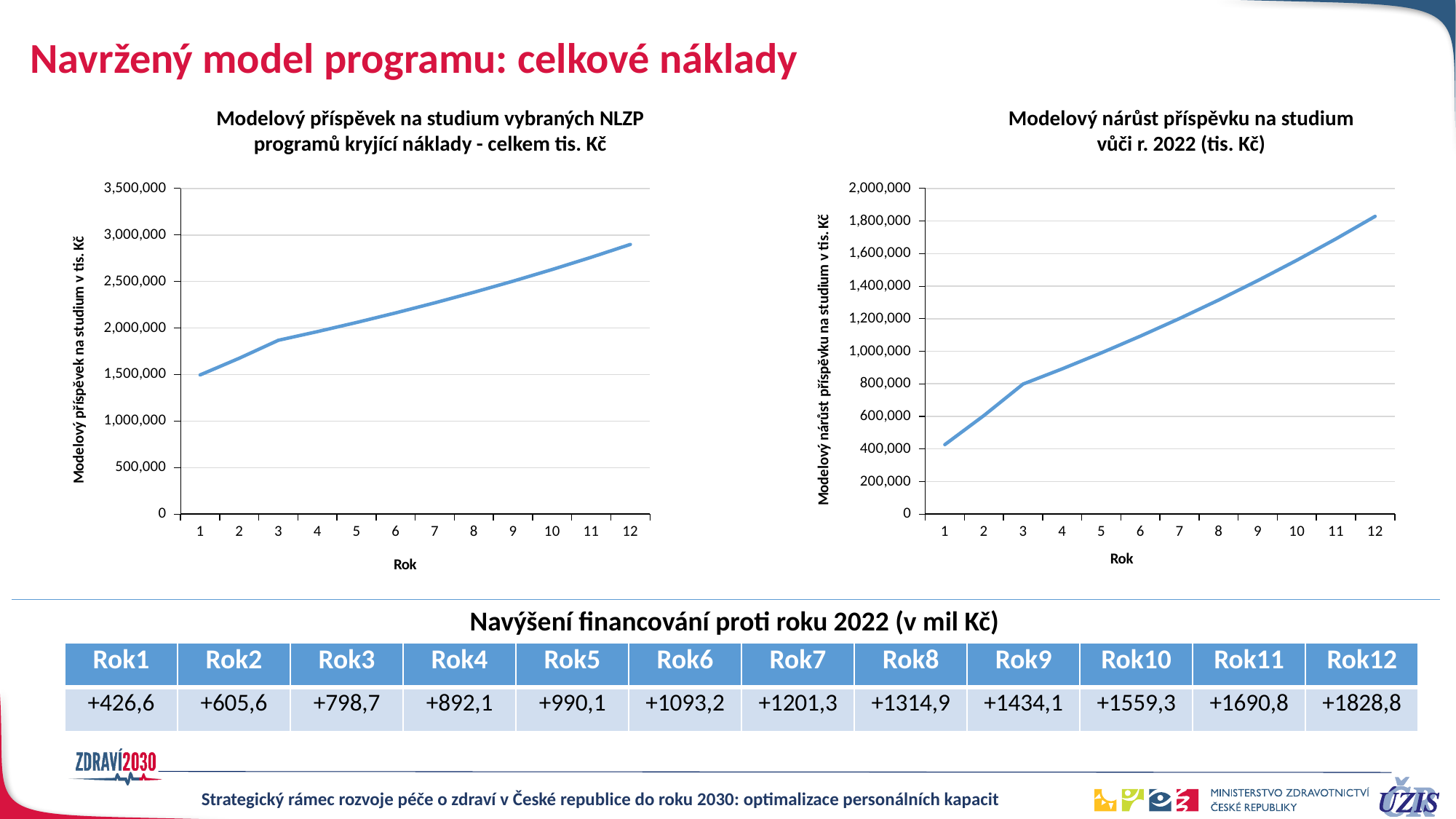
In the left chart, is the value for year 1 greater or less than 2,000,000? less In the left chart, do the values rise or fall from year 1 to year 12? rise In the right chart, is the value for year 12 greater or less than 1,500,000? greater What kind of chart is the left chart titled 'Modelový příspěvek na studium vybraných NLZP programů kryjící náklady - celkem tis. Kč'? line chart In the right chart, how many years (points) are plotted along the x axis? 12 In the right chart, is the value for year 1 greater or less than 600,000? less In the right chart, do the values rise or fall from year 1 to year 12? rise In the left chart, how many years (points) are plotted along the x axis? 12 What is the x-axis label of the right chart? Rok What kind of chart is the right chart titled 'Modelový nárůst příspěvku na studium vůči r. 2022 (tis. Kč)'? line chart In the left chart, which year has the highest value? 12